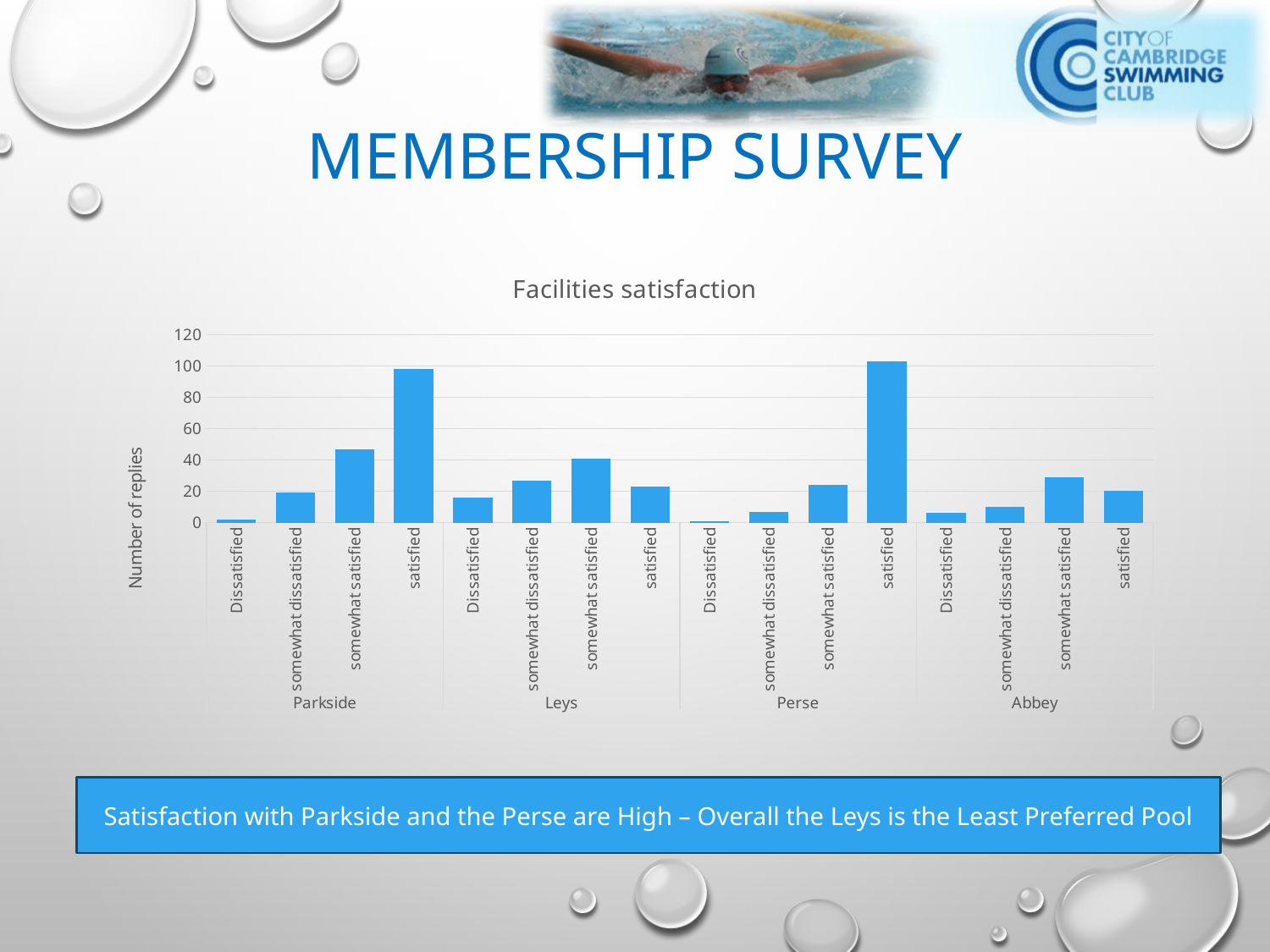
How many pools are shown as groups along the x axis of the chart? 4 What type of chart is shown on the slide? Bar chart What is the title of the chart? Facilities satisfaction How many bars are plotted in the chart in total? 16 Which is larger: the number of Dissatisfied replies for Leys or for Perse? Leys Which bar in the chart has the highest number of replies? Perse satisfied Which is larger: the number of satisfied replies for Parkside or for Leys? Parkside Is the value for Leys Dissatisfied greater or less than 20? less Is the value for Parkside satisfied greater or less than 80? greater Is the value for Abbey satisfied greater or less than 40? less What is the label on the vertical axis of the chart? Number of replies